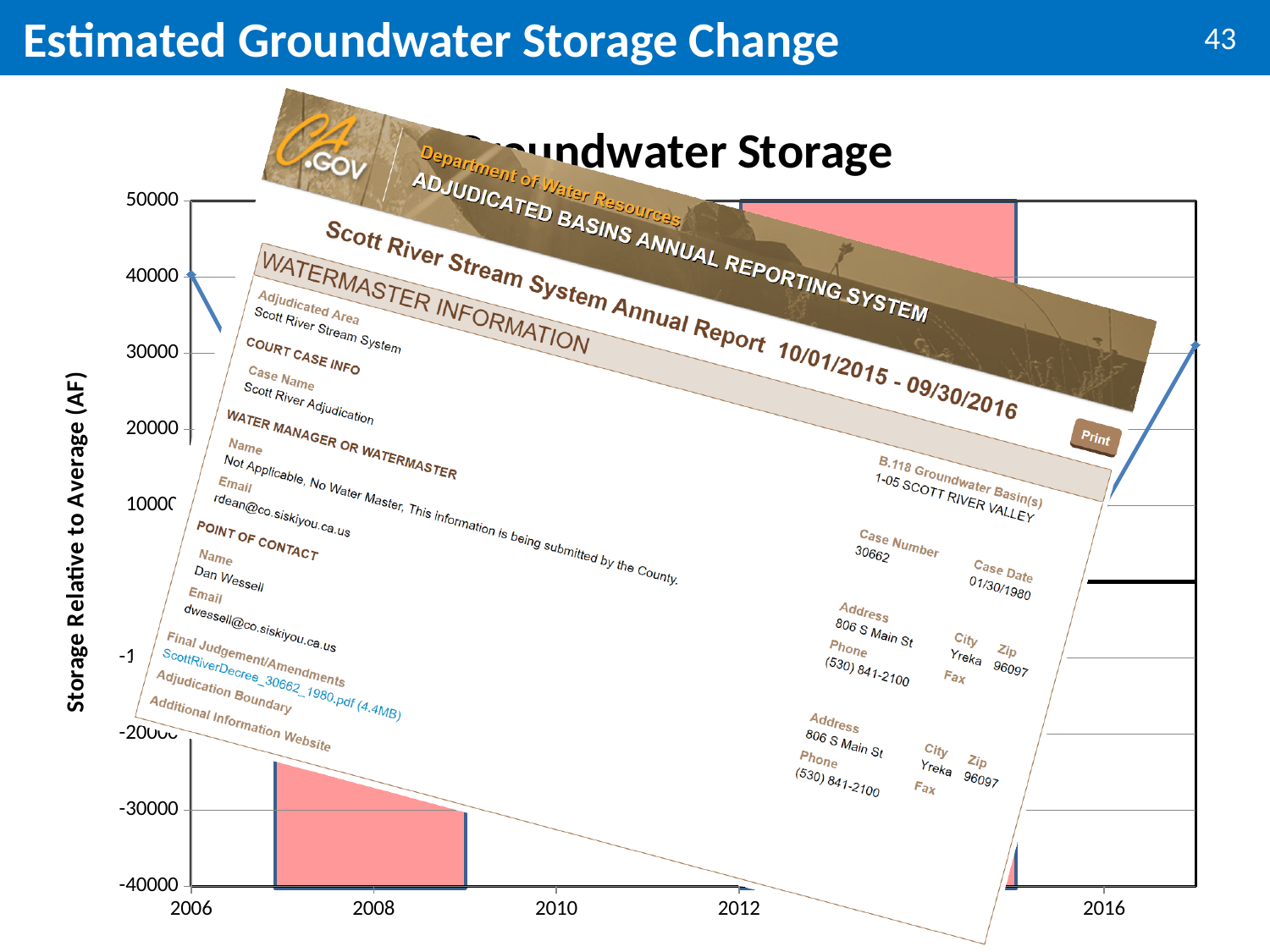
What is the lowest value shown on the chart's vertical axis? -40000 What is the last year labeled on the chart's horizontal axis? 2016 What is the highest value shown on the chart's vertical axis? 50000 Does the line rise or fall immediately after 2006? fall What is the title shown at the top of the slide? Estimated Groundwater Storage Change What is the label on the vertical axis of the chart? Storage Relative to Average (AF) Does the line rise or fall between 2015 and 2016? rise What is the first year labeled on the chart's horizontal axis? 2006